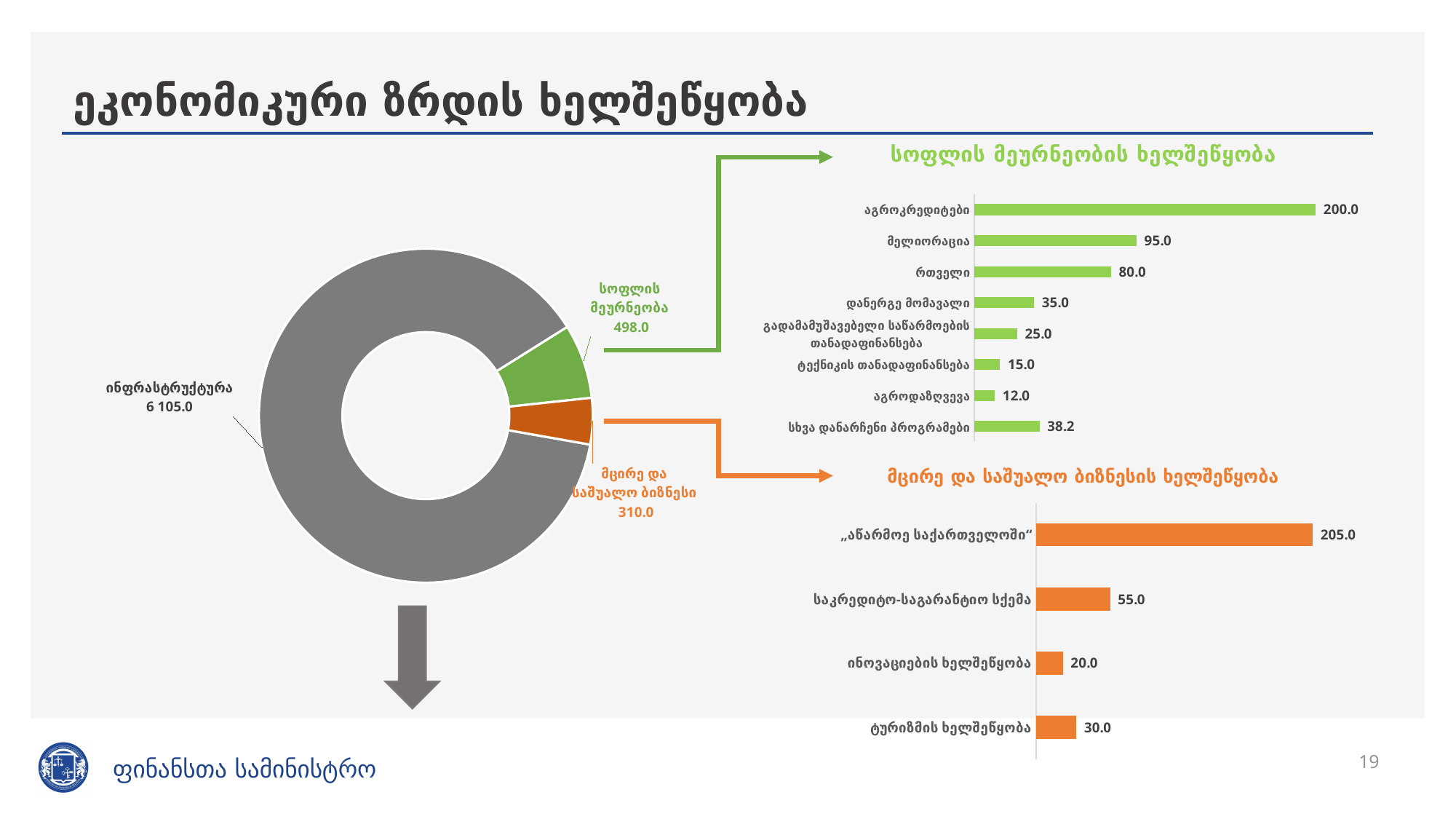
In the green bar chart titled "სოფლის მეურნეობის ხელშეწყობა", what is the difference between მელიორაცია and რთველი? 15.0 In the orange bar chart titled "მცირე და საშუალო ბიზნესის ხელშეწყობა", how many categories are shown? 4 In the green bar chart titled "სოფლის მეურნეობის ხელშეწყობა", how many categories are shown? 8 In the donut chart on the left, what is the value for ინფრასტრუქტურა? 6 105.0 In the green bar chart titled "სოფლის მეურნეობის ხელშეწყობა", which category has the lowest value? აგროდაზღვევა In the green bar chart titled "სოფლის მეურნეობის ხელშეწყობა", which is larger: დანერგე მომავალი or სხვა დანარჩენი პროგრამები? სხვა დანარჩენი პროგრამები What kind of chart is the chart on the left side of the slide? Donut chart In the green bar chart titled "სოფლის მეურნეობის ხელშეწყობა", what is the value for აგროკრედიტები? 200.0 In the orange bar chart titled "მცირე და საშუალო ბიზნესის ხელშეწყობა", what is the difference between ტურიზმის ხელშეწყობა and ინოვაციების ხელშეწყობა? 10.0 In the orange bar chart titled "მცირე და საშუალო ბიზნესის ხელშეწყობა", which category has the highest value? „აწარმოე საქართველოში“ In the orange bar chart titled "მცირე და საშუალო ბიზნესის ხელშეწყობა", what is the value for საკრედიტო-საგარანტიო სქემა? 55.0 In the donut chart on the left, which is larger: სოფლის მეურნეობა or მცირე და საშუალო ბიზნესი? სოფლის მეურნეობა